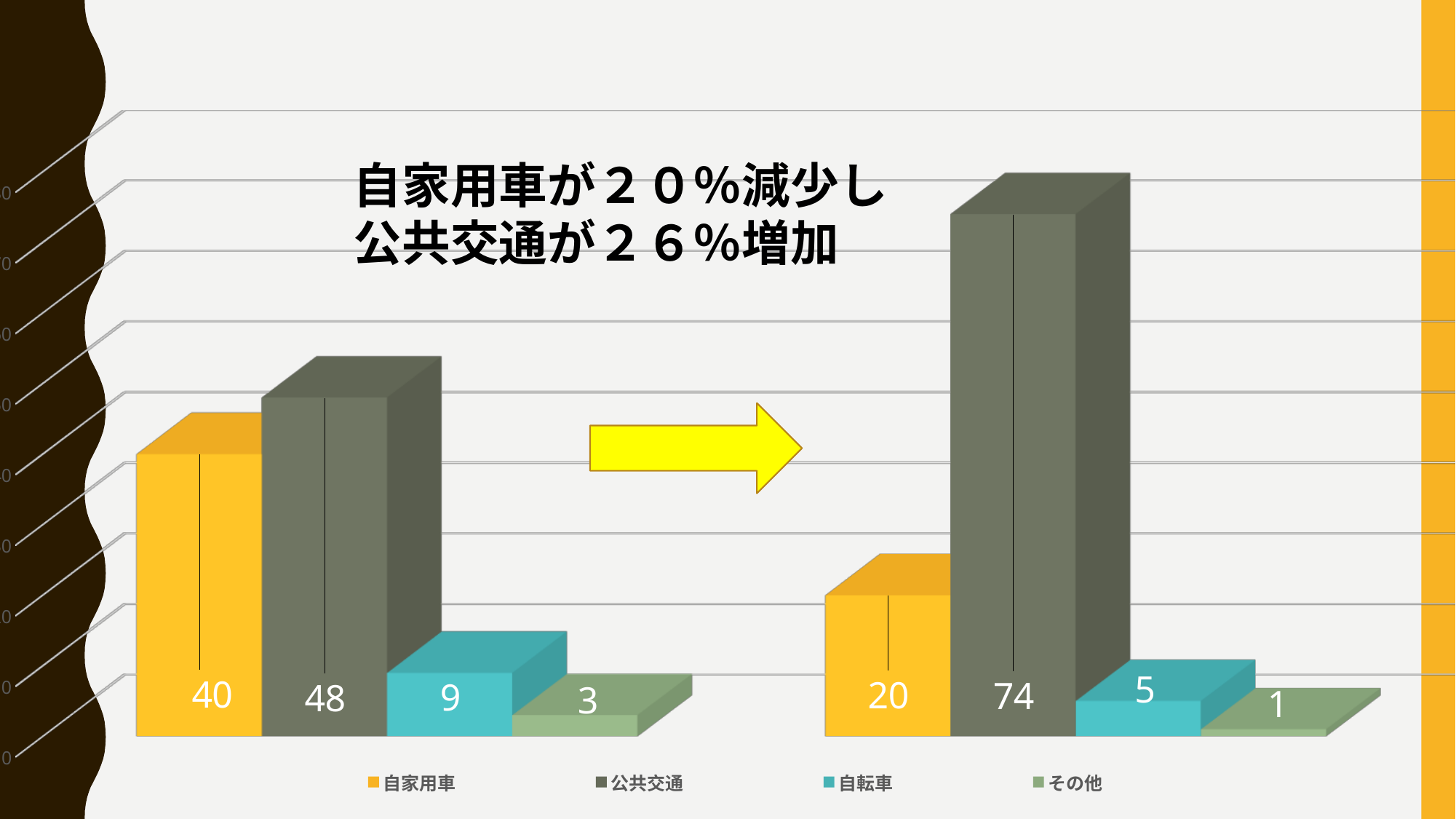
What is the value of 自家用車 in the left group of bars? 40 What is the difference between 公共交通 in the right group and 公共交通 in the left group? 26 Which legend entry is shown in orange? 自家用車 What is the value of 自転車 in the left group of bars? 9 Which series has the lowest value in the left group of bars? その他 How many series does the legend list? 4 How many groups of bars are plotted in the chart? 2 Which is larger: 自家用車 in the left group or 自家用車 in the right group? 自家用車 in the left group What is the value of その他 in the right group of bars? 1 What is the value of 公共交通 in the right group of bars? 74 Which series has the highest value in the right group of bars? 公共交通 What type of chart is shown on the slide? bar chart